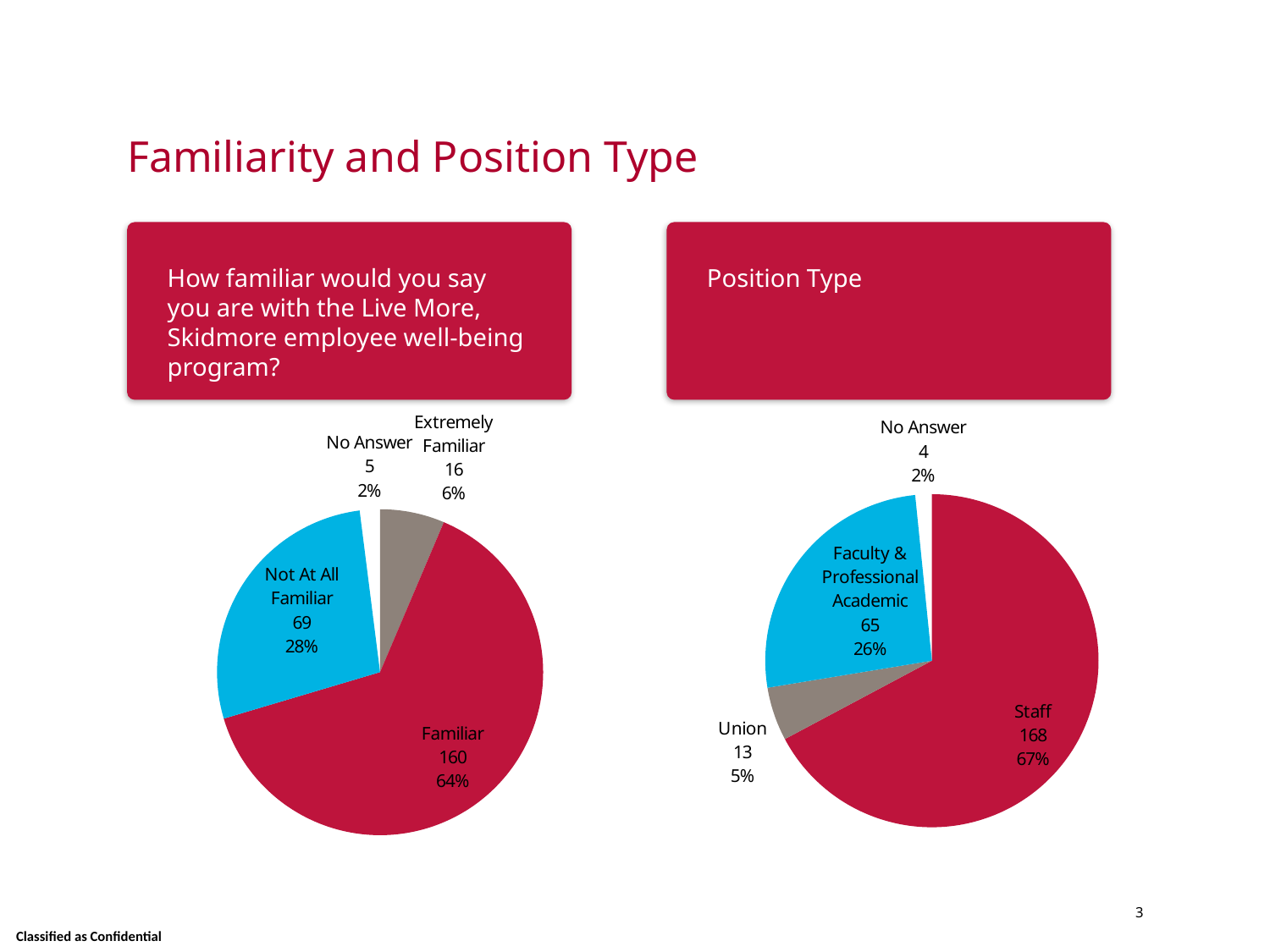
In the Position Type pie chart on the right, what is the difference between the Staff count and the Union count? 155 What type of chart is used for Position Type on the right? Pie chart In the Position Type pie chart on the right, which is larger, Union or Faculty & Professional Academic? Faculty & Professional Academic In the familiarity pie chart on the left, which category has the largest slice? Familiar In the familiarity pie chart on the left, which category has the smallest slice? No Answer In the familiarity pie chart on the left, how many more respondents were Not At All Familiar than Extremely Familiar? 53 In the familiarity pie chart on the left, how many respondents answered Familiar? 160 In the Position Type pie chart on the right, what colour is the Staff slice? Red In the Position Type pie chart on the right, how many respondents are Staff? 168 In the familiarity pie chart on the left, how many categories are shown? 4 In the Position Type pie chart on the right, what share of respondents are Faculty & Professional Academic? 26% In the familiarity pie chart on the left, what share of respondents were Not At All Familiar? 28%